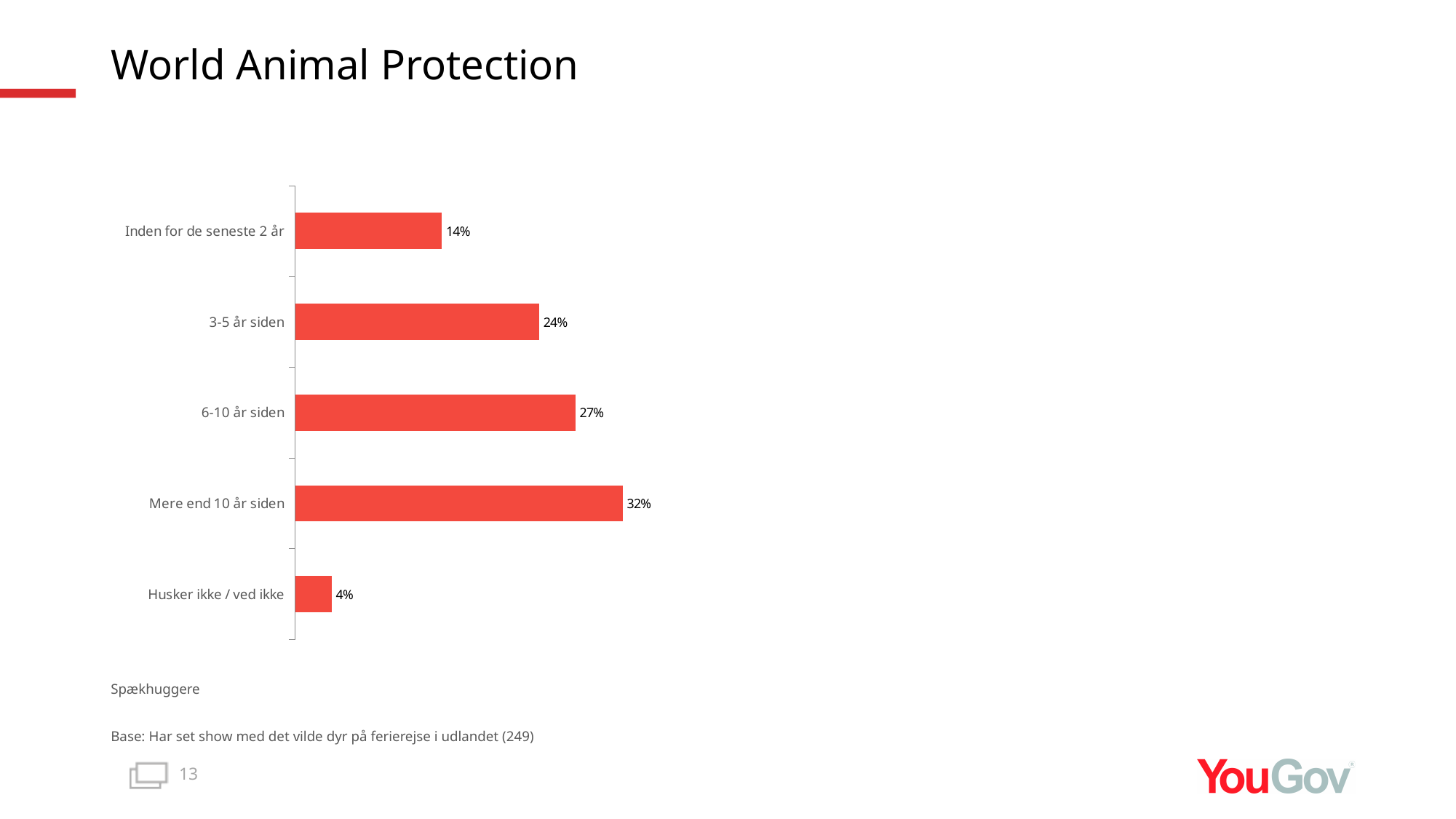
What is the value for "Inden for de seneste 2 år"? 14% What kind of chart is shown on the slide? Bar chart How many categories are shown in the chart? 5 What is the difference between "Mere end 10 år siden" and "Inden for de seneste 2 år"? 18 percentage points Which category has the highest value? Mere end 10 år siden Which is larger: "3-5 år siden" or "6-10 år siden"? 6-10 år siden What is the value for "3-5 år siden"? 24% What is the value for "6-10 år siden"? 27% Which category has the lowest value? Husker ikke / ved ikke What is the value for "Mere end 10 år siden"? 32% What is the base (sample size) stated below the chart? 249 What is the value for "Husker ikke / ved ikke"? 4%